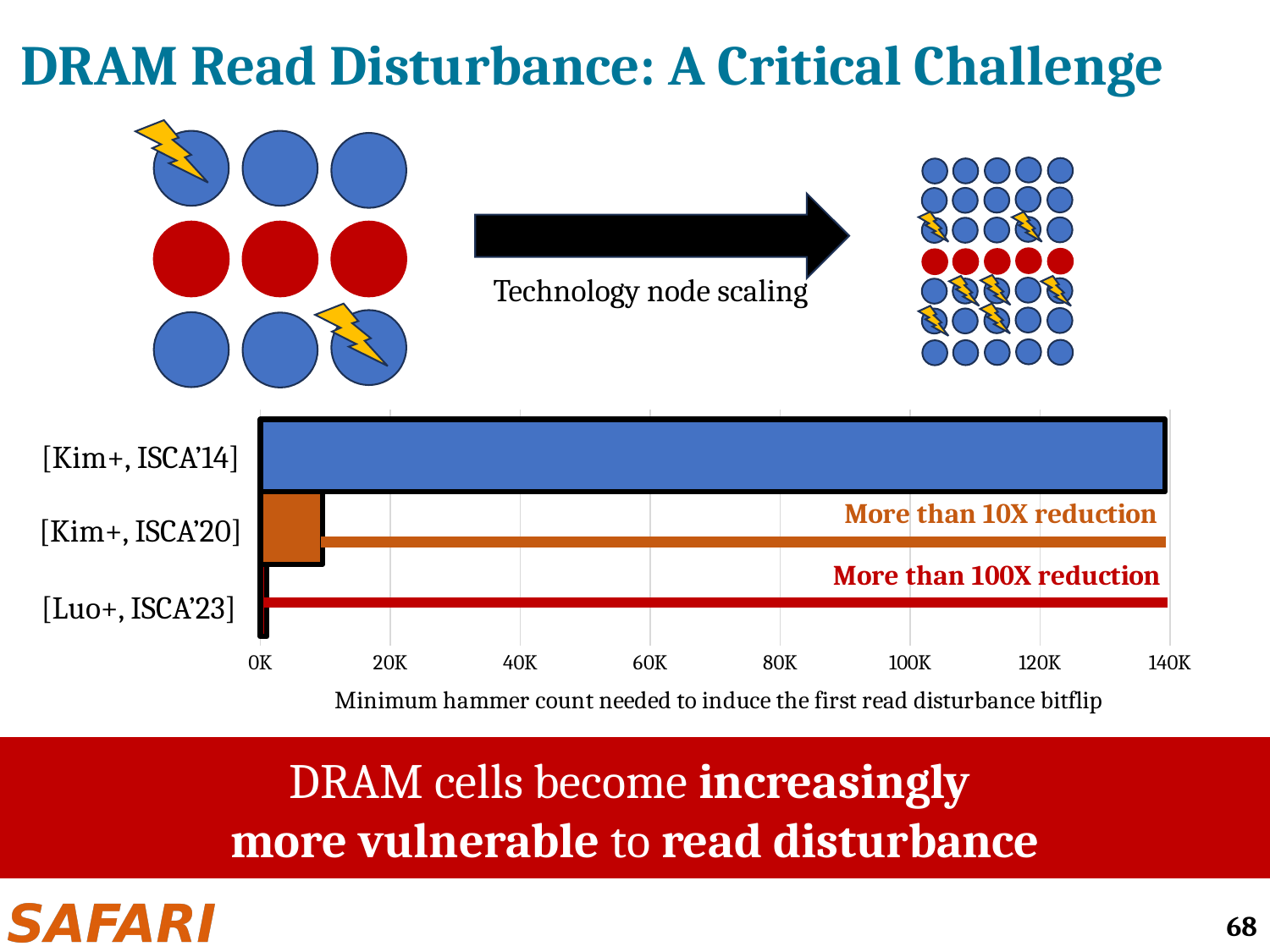
What is the label of the x axis of the bar chart? Minimum hammer count needed to induce the first read disturbance bitflip Is the value for [Kim+, ISCA'14] greater or less than 120K? greater Is the value for [Kim+, ISCA'20] greater or less than 20K? less Which category has the highest minimum hammer count in the bar chart? [Kim+, ISCA'14] How many categories (studies) are plotted in the bar chart? 3 Which category has the lowest minimum hammer count in the bar chart? [Luo+, ISCA'23] What reduction does the annotation next to the [Luo+, ISCA'23] bar state? More than 100X reduction What kind of chart is shown on the slide? bar chart Is the value for [Luo+, ISCA'23] greater or less than 20K? less Do the minimum hammer counts rise or fall going from [Kim+, ISCA'14] to [Luo+, ISCA'23]? fall Which is larger, the value for [Kim+, ISCA'20] or the value for [Luo+, ISCA'23]? [Kim+, ISCA'20]